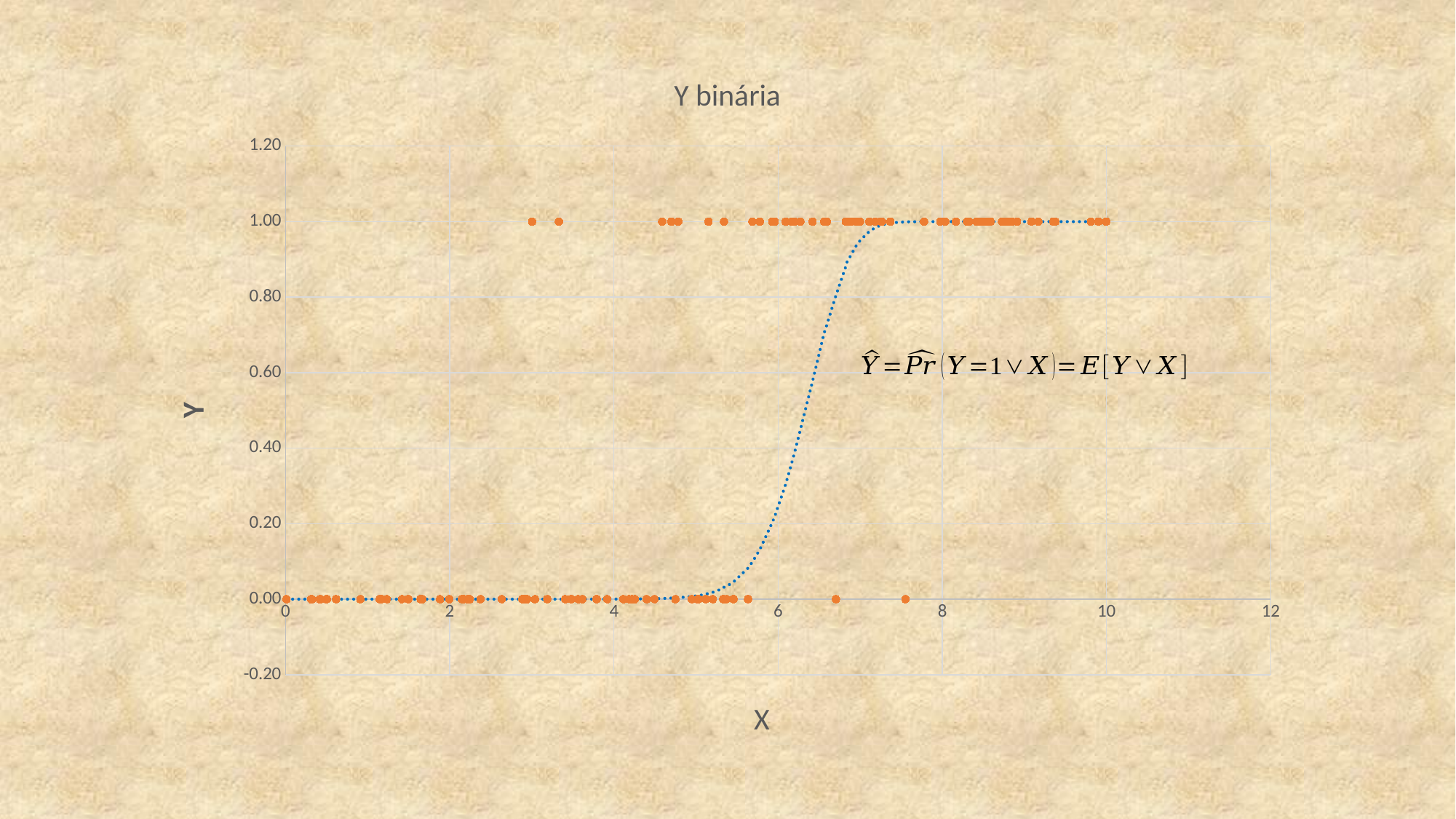
Is the value of the blue dotted curve at X = 7 greater or less than 0.80? greater What is the highest tick value shown on the Y axis? 1.20 What is the lowest Y value reached by the orange data points? 0.00 What is the label of the horizontal axis? X What is the highest Y value reached by the orange data points? 1.00 Is the value of the blue dotted curve at X = 4 greater or less than 0.20? less Does the blue dotted curve rise or fall as X increases? rises What kind of chart is shown on the slide? scatter chart Is the value of the blue dotted curve at X = 8 greater or less than 0.60? greater What is the highest tick value shown on the X axis? 12 What is the title of the chart? Y binária